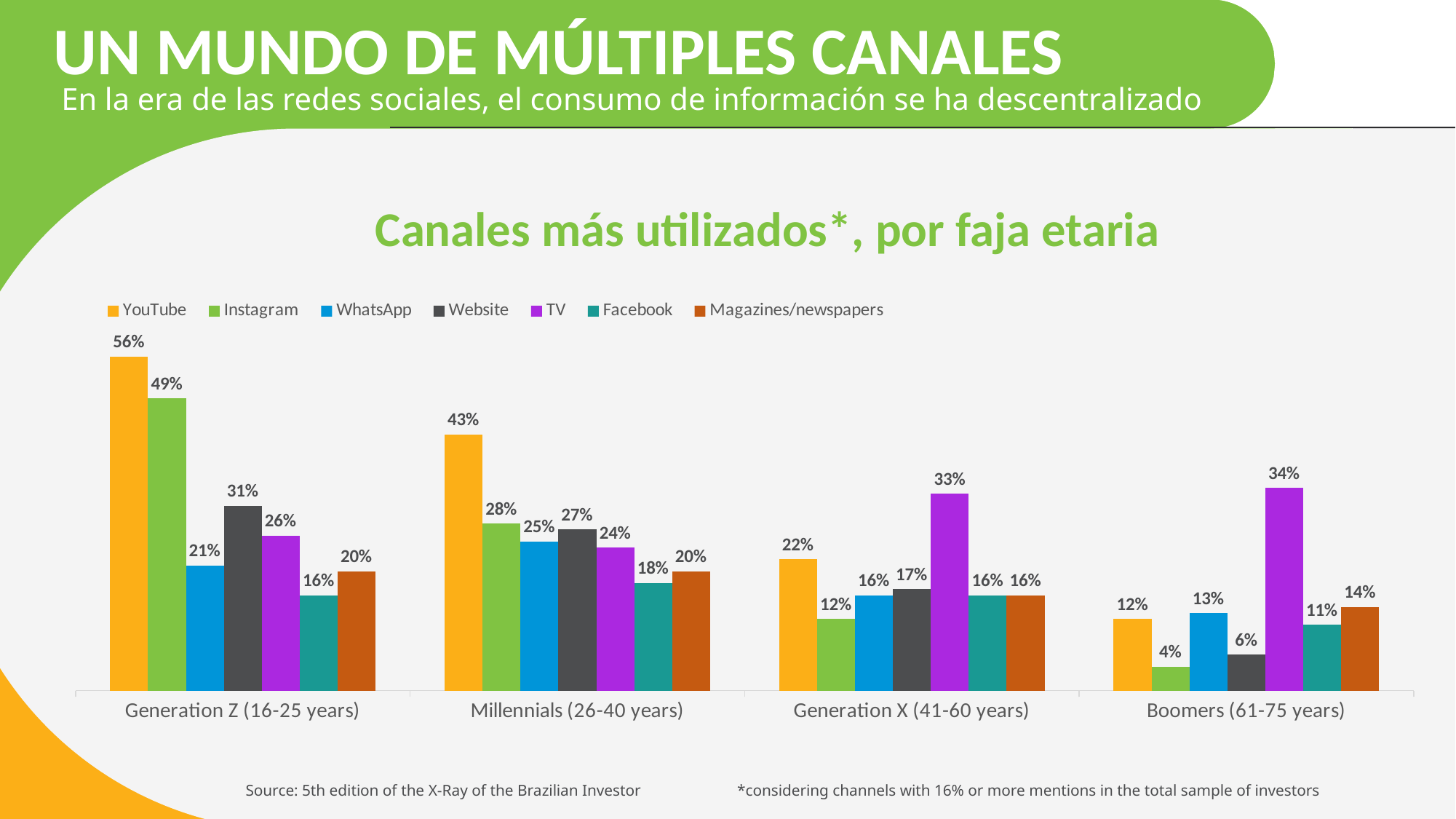
Which channel has the highest value in the Generation X (41-60 years) group? TV What is the value for TV in the Boomers (61-75 years) group? 34% Which is larger for Millennials (26-40 years): WhatsApp or Website? Website How many series does the legend list? 7 Do the YouTube values rise or fall from Generation Z to Boomers? Fall Which channel has the lowest value in the Boomers (61-75 years) group? Instagram How many age groups are shown on the x axis? 4 What is the title of the chart? Canales más utilizados*, por faja etaria What kind of chart is shown on the slide? Bar chart What is the value for YouTube in the Generation Z (16-25 years) group? 56% What is the difference between YouTube and Instagram in the Generation Z (16-25 years) group? 7% What is the value for Website in the Millennials (26-40 years) group? 27%